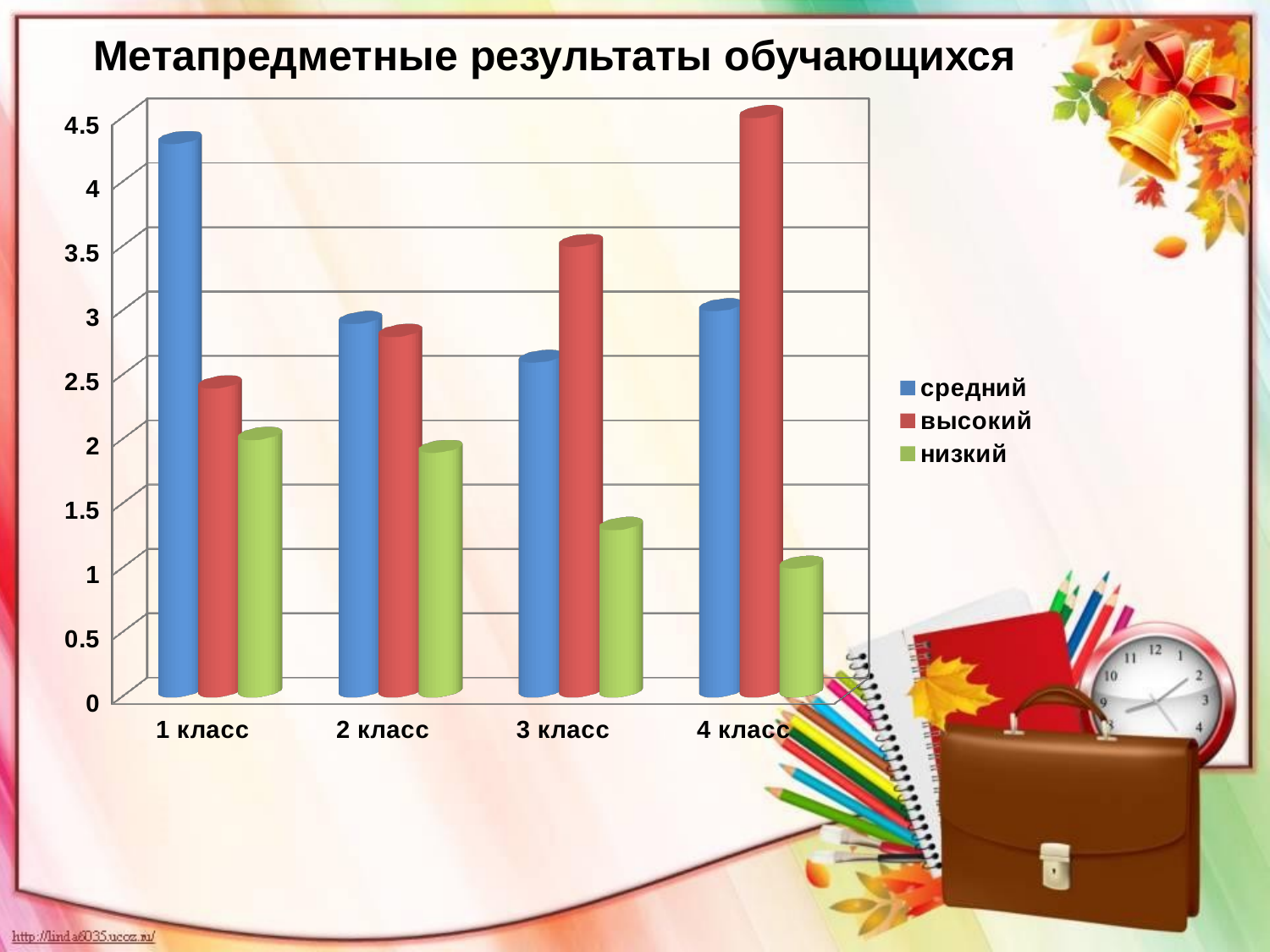
Which class has the highest value for the 'высокий' series? 4 класс What kind of chart is shown on the slide? bar chart Which class has the highest value for the 'средний' series? 1 класс In 4 класс, which is larger: 'высокий' or 'средний'? высокий Is the value for 'низкий' in 3 класс greater or less than 1.5? less In 1 класс, which is larger: 'средний' or 'высокий'? средний How many classes (categories) are shown on the x axis? 4 How many series does the legend list? 3 What is the title of the chart on the slide? Метапредметные результаты обучающихся Do the values of the 'низкий' series rise or fall from 1 класс to 4 класс? fall Which class has the lowest value for the 'низкий' series? 4 класс Is the value for 'средний' in 1 класс greater or less than 4? greater